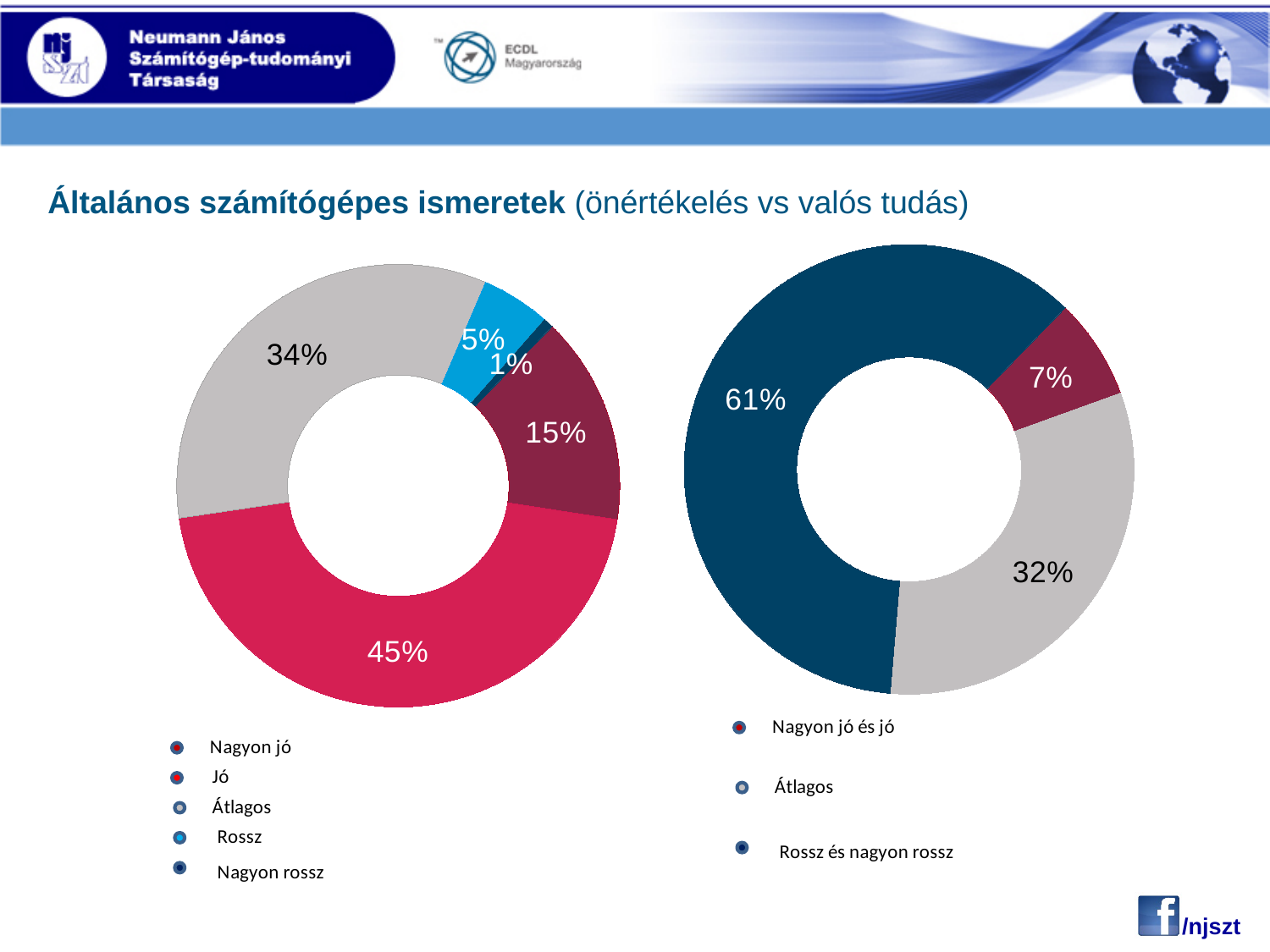
In the left chart, which is larger: the grey slice or the dark red slice? The grey slice (34%) How many slices does the right chart have? 3 What is the title of the slide containing the two charts? Általános számítógépes ismeretek (önértékelés vs valós tudás) How many legend entries does the right chart list? 3 In the left chart, what is the difference between the 45% slice and the 34% slice? 11% How many slices does the left chart have? 5 What kind of chart is shown on the left side of the slide? Pie (donut) chart In the left chart, what is the largest slice's value? 45% In the right chart, what is the smallest slice's value? 7% In the right chart, what is the difference between the 61% slice and the 32% slice? 29% In the left chart, what is the smallest slice's value? 1% In the right chart, what is the largest slice's value? 61%